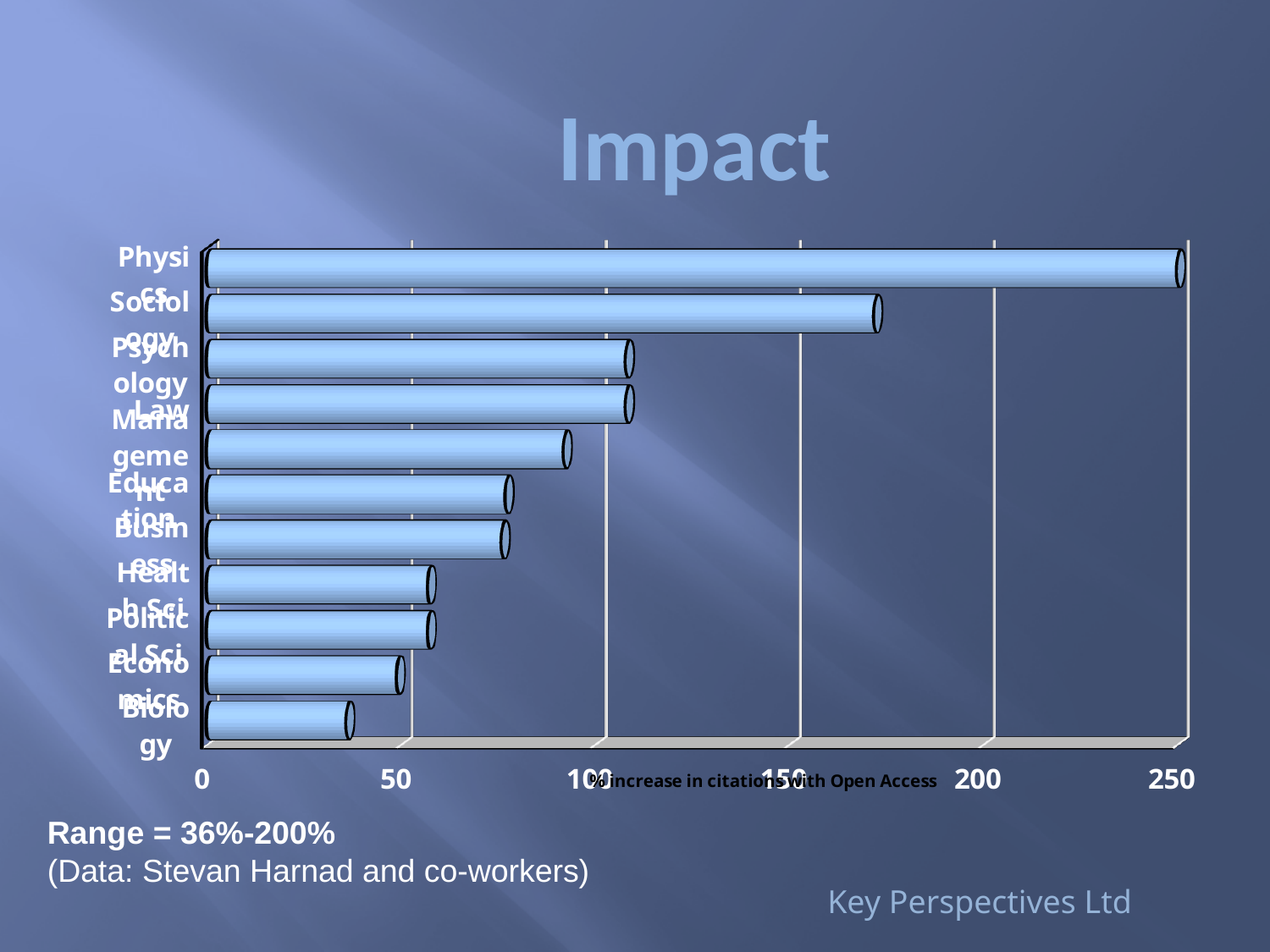
Is the value for Education greater or less than 50? greater What is the label on the horizontal axis of the chart? % increase in citations with Open Access How many categories (disciplines) are plotted in the chart? 11 Which discipline has the highest % increase in citations with Open Access? Physics Is the value for Management greater or less than 100? less What is the title of the chart? Impact Which has a larger value, Economics or Management? Management Which discipline has the lowest % increase in citations with Open Access? Biology Which has a larger value, Sociology or Psychology? Sociology Is the value for Biology greater or less than 50? less What kind of chart is shown on the slide? bar chart